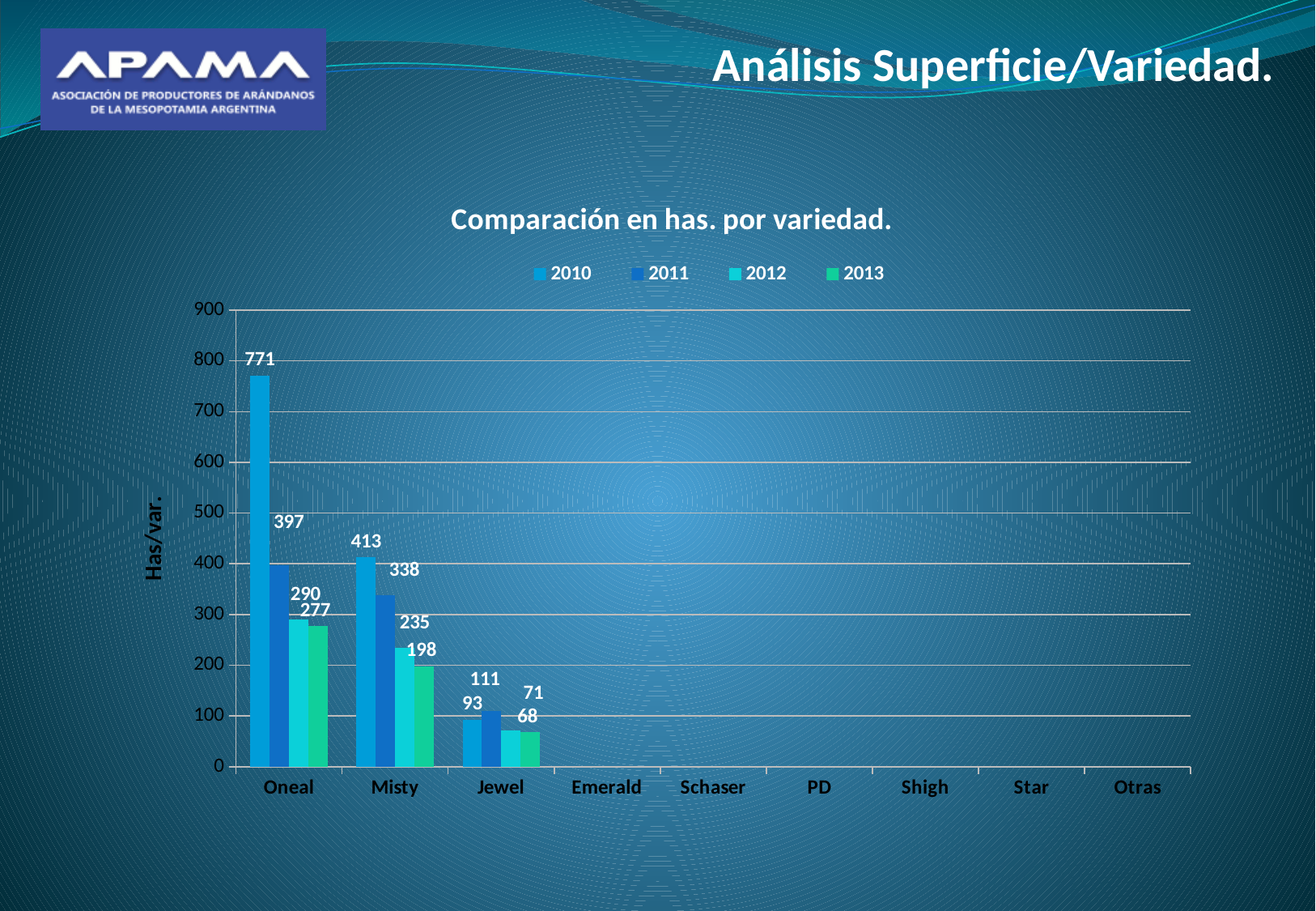
Do the values for Misty rise or fall from 2010 to 2013? Fall What kind of chart is shown? Bar chart What is the value for Misty in 2013? 198 What is the value for Oneal in 2010? 771 What is the value for Misty in 2011? 338 Among Oneal, Misty and Jewel, which has the lowest value in 2012? Jewel How many varieties are listed on the x axis? 9 Which variety has the highest value in 2010? Oneal What is the difference between the 2010 and 2011 values for Oneal? 374 How many series does the legend list? 4 What is the value for Jewel in 2013? 68 Which is larger for Jewel: the 2010 value or the 2011 value? 2011